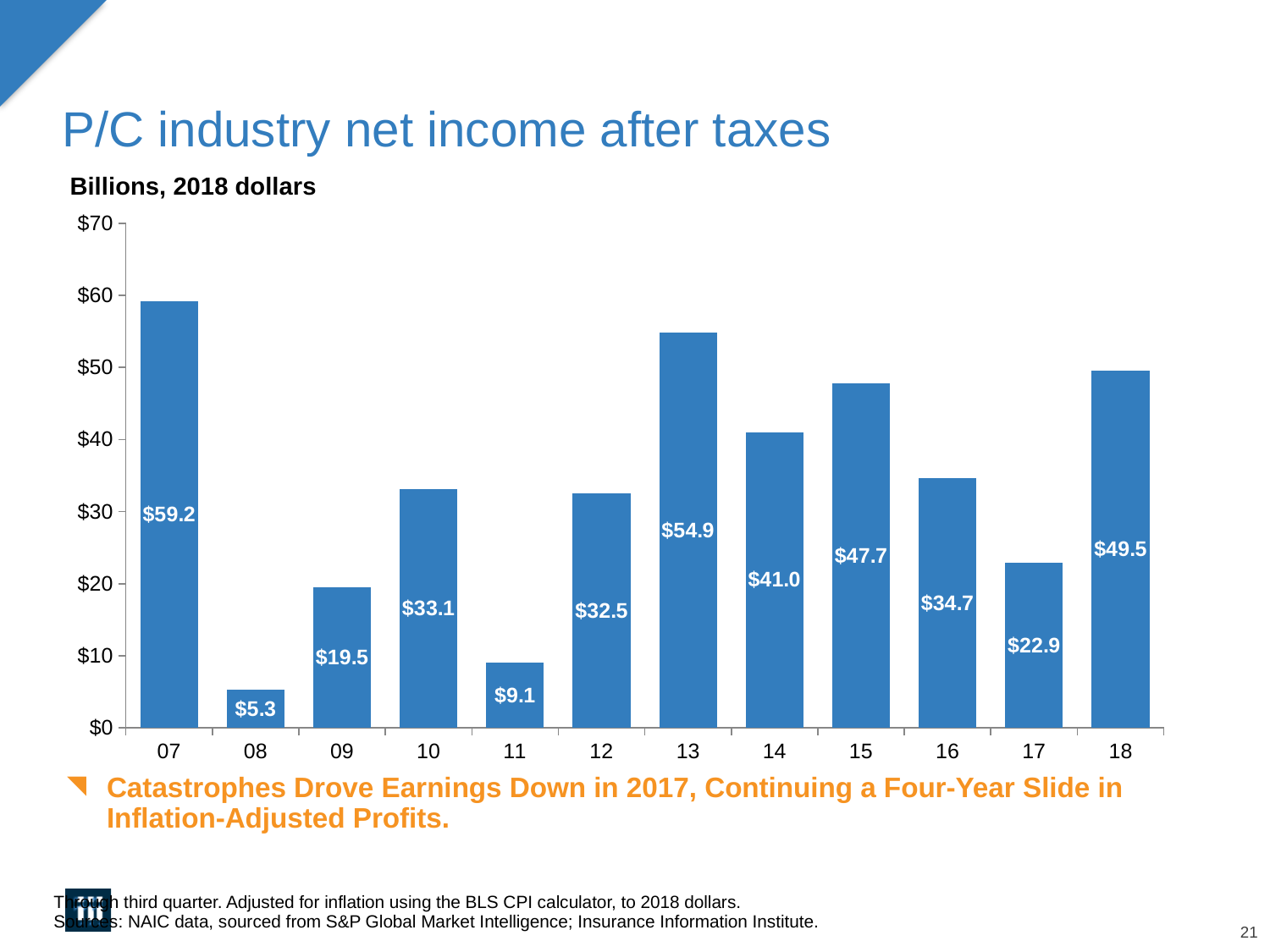
How many years are shown on the x axis? 12 Is the value for 2016 greater or less than $30? greater What is the P/C industry net income after taxes for 2013? $54.9 What is the difference between the values for 2007 and 2008? $53.9 Which year has the highest net income after taxes? 07 Which year has the lowest net income after taxes? 08 What is the value shown for 2011? $9.1 What kind of chart is shown on the slide? Bar chart What is the value shown for 2017? $22.9 Which is larger, the value for 2014 or the value for 2015? 2015 Do the values rise or fall from 2013 to 2017? Fall What is the difference between the values for 2018 and 2017? $26.6